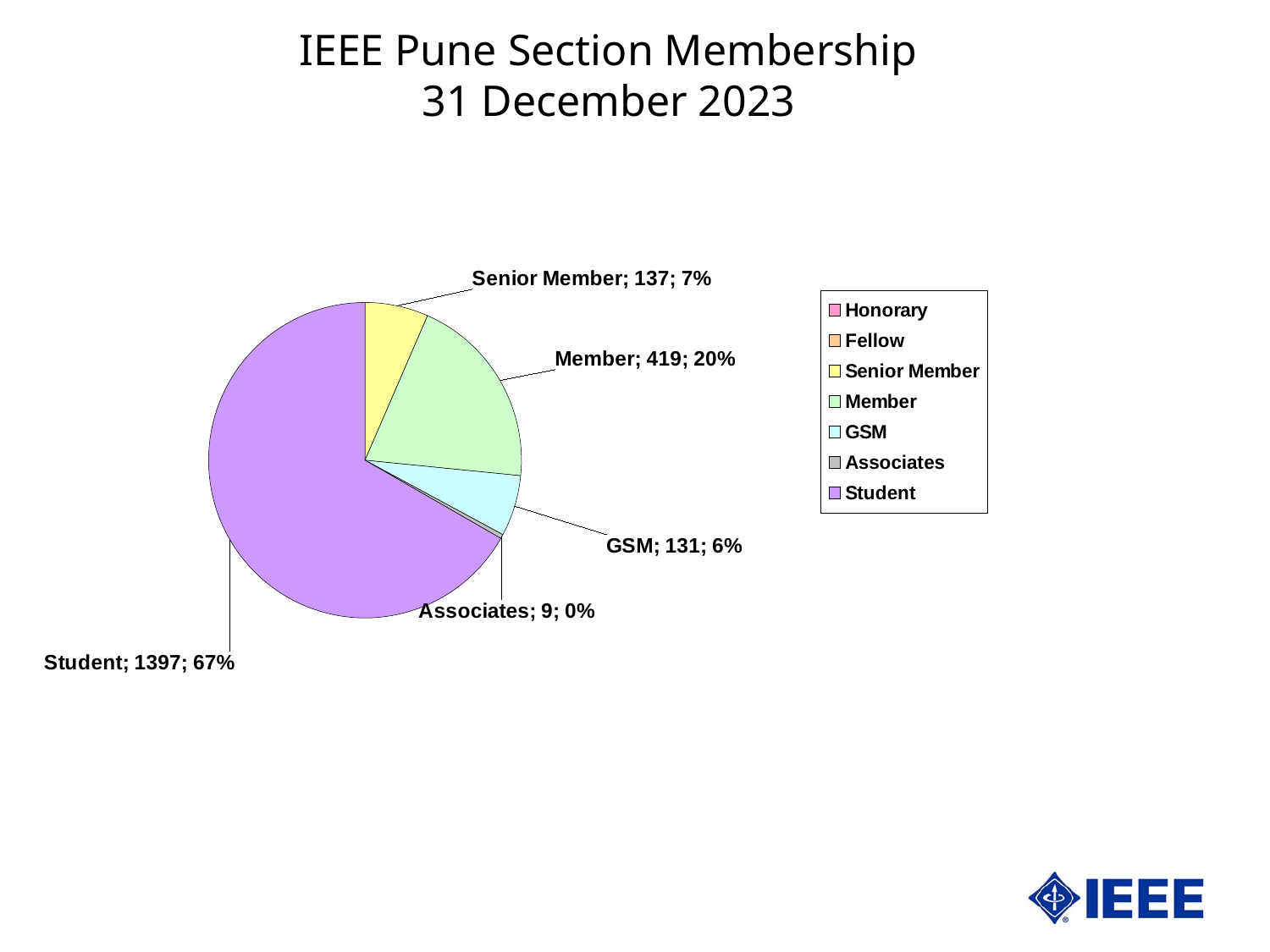
How many members are in the Student category? 1397 What is the value shown for Member? 419 Which category has the largest slice of the pie? Student What is the difference between the Member and Senior Member values? 282 What share of the pie does the Student slice represent? 67% What is the value shown for Senior Member? 137 How many entries does the legend list? 7 What share of the pie does the Member slice represent? 20% What is the value shown for GSM? 131 What is the value shown for Associates? 9 What kind of chart is shown on the slide? pie chart Which is larger, the value for Senior Member or the value for GSM? Senior Member